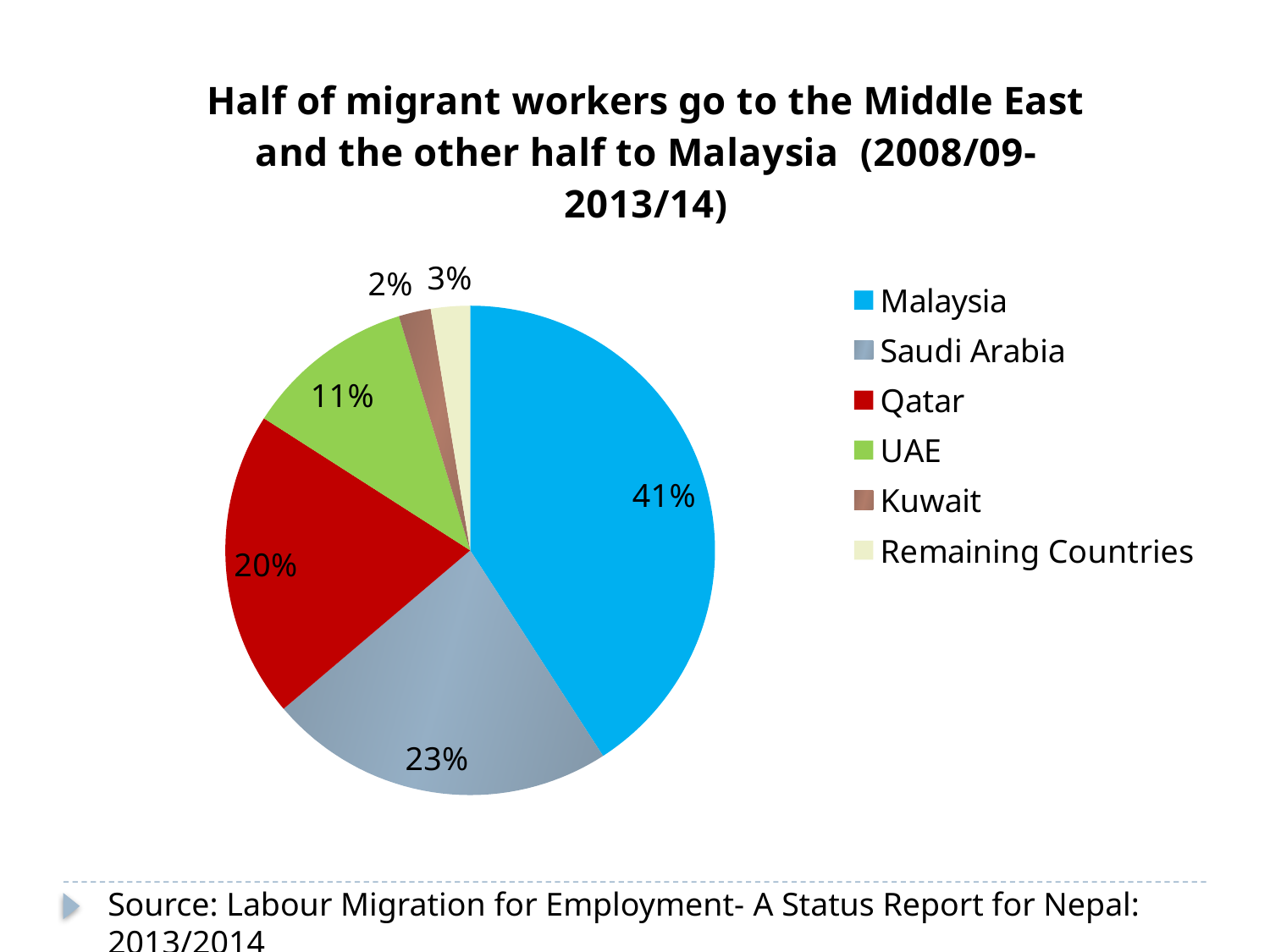
What share of migrant workers go to the UAE? 11% What share of migrant workers go to Malaysia? 41% How many categories does the pie chart show? 6 What share of migrant workers go to Kuwait? 2% What share of migrant workers go to Saudi Arabia? 23% What is the difference in percentage points between the shares for Malaysia and Saudi Arabia? 18 What share of migrant workers go to Qatar? 20% Which has a larger share, Qatar or UAE? Qatar What is the combined share of Saudi Arabia and Qatar? 43% What kind of chart is shown on the slide? Pie chart Which destination receives the largest share of migrant workers? Malaysia Which destination receives the smallest share of migrant workers? Kuwait